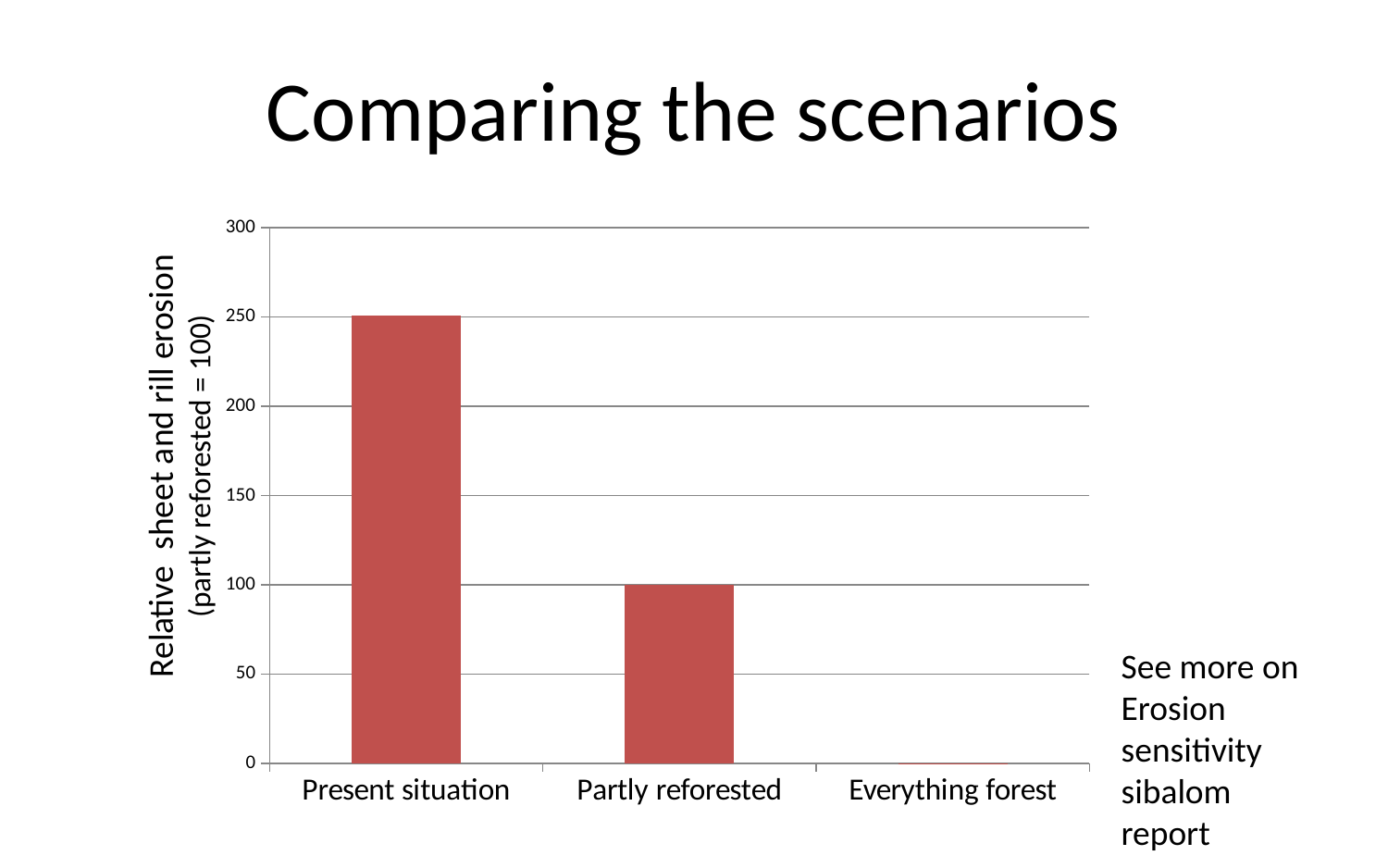
What is the relative sheet and rill erosion value for Partly reforested? 100 What is the label of the vertical axis? Relative sheet and rill erosion (partly reforested = 100) Which scenario has the highest relative sheet and rill erosion? Present situation What kind of chart is shown on the slide? bar chart Which scenario has the lowest relative sheet and rill erosion? Everything forest Which is larger, the value for Present situation or the value for Partly reforested? Present situation Do the values rise or fall moving from left to right along the x axis? fall Is the value for Everything forest greater or less than 50? less How many scenarios (categories) are shown on the x axis? 3 Is the value for Present situation greater or less than 200? greater